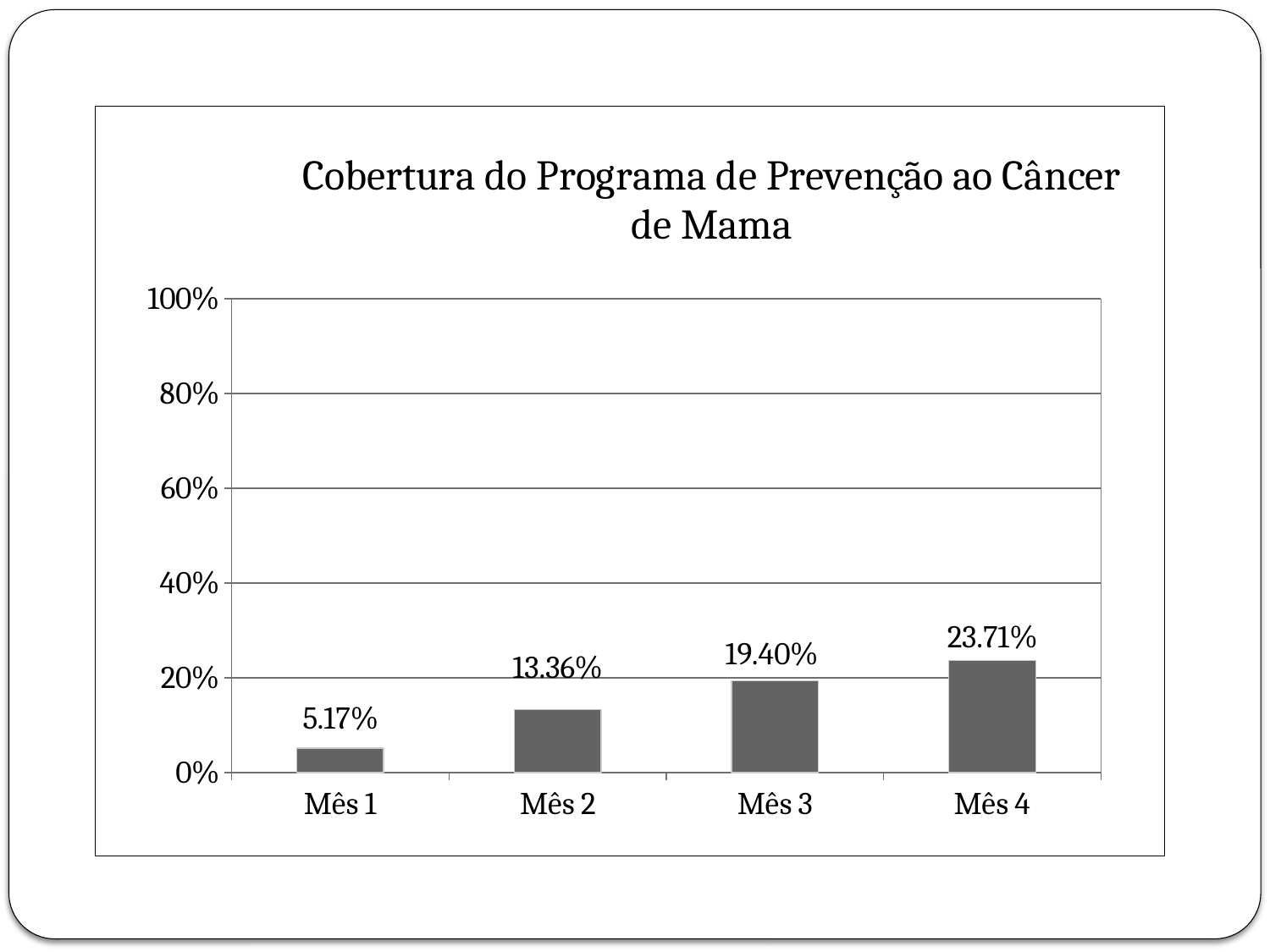
What is the value for Mês 3? 19.40% How many months are shown on the x axis? 4 Do the values rise or fall from Mês 1 to Mês 4? rise Which is larger, the value for Mês 2 or the value for Mês 3? Mês 3 Which month has the lowest value? Mês 1 What is the value for Mês 1? 5.17% What is the difference between the values for Mês 3 and Mês 2? 6.04% Is the value for Mês 4 greater or less than 20%? greater Which month has the highest value? Mês 4 What kind of chart is shown on the slide? bar chart What is the value for Mês 4? 23.71% What is the difference between the values for Mês 4 and Mês 1? 18.54%